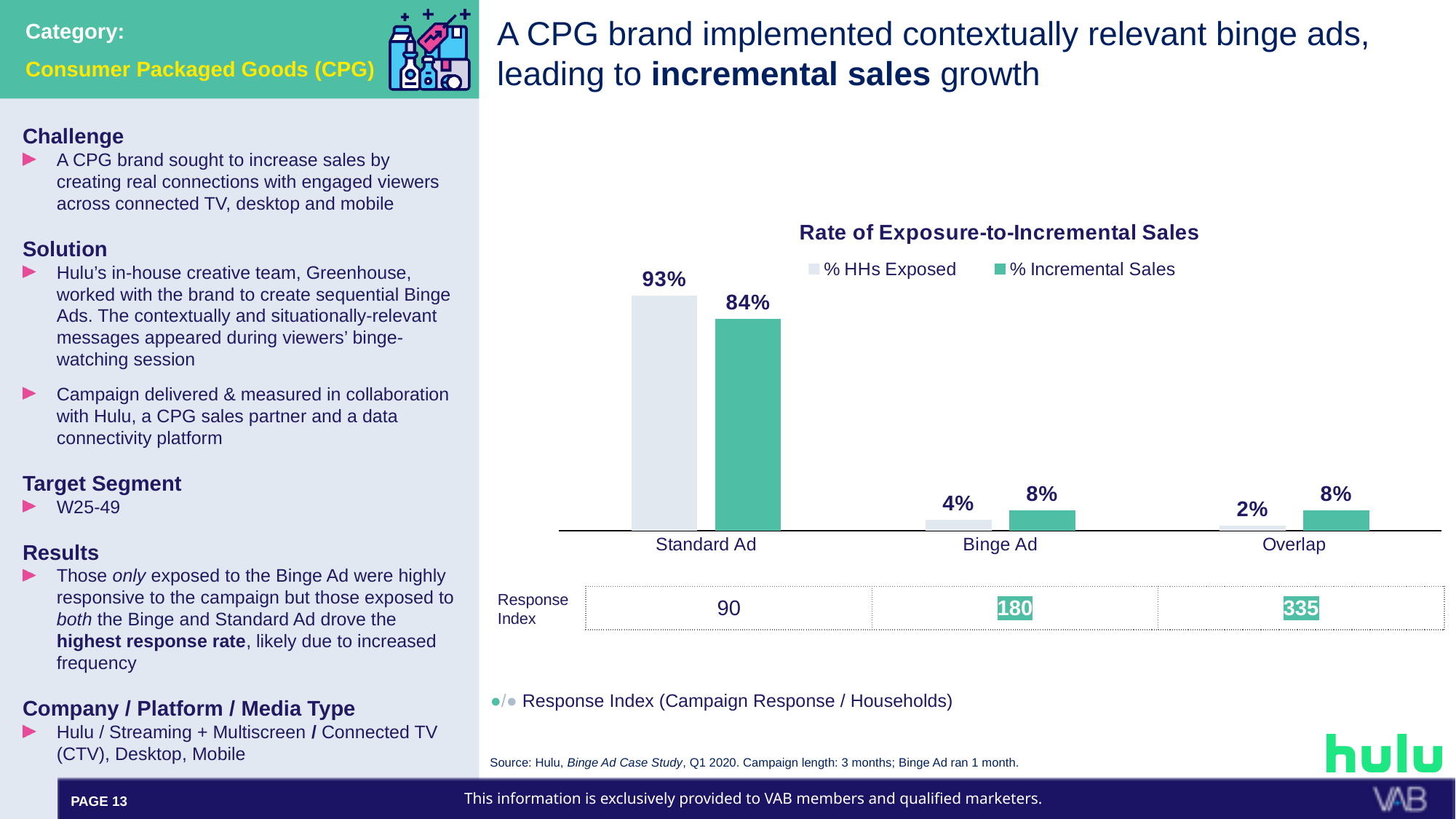
What is the % HHs Exposed value for Standard Ad? 93% Which category has the highest % Incremental Sales? Standard Ad What kind of chart is shown on the slide? Bar chart What is the Response Index shown for Overlap? 335 For Binge Ad, which is larger: % HHs Exposed or % Incremental Sales? % Incremental Sales How many categories are shown on the x axis of the chart? 3 Which category has the lowest % HHs Exposed? Overlap How many series does the chart legend list? 2 What is the % Incremental Sales value for Binge Ad? 8% What is the % HHs Exposed value for Overlap? 2% What is the title of the chart? Rate of Exposure-to-Incremental Sales What is the difference between % HHs Exposed and % Incremental Sales for Standard Ad? 9 percentage points